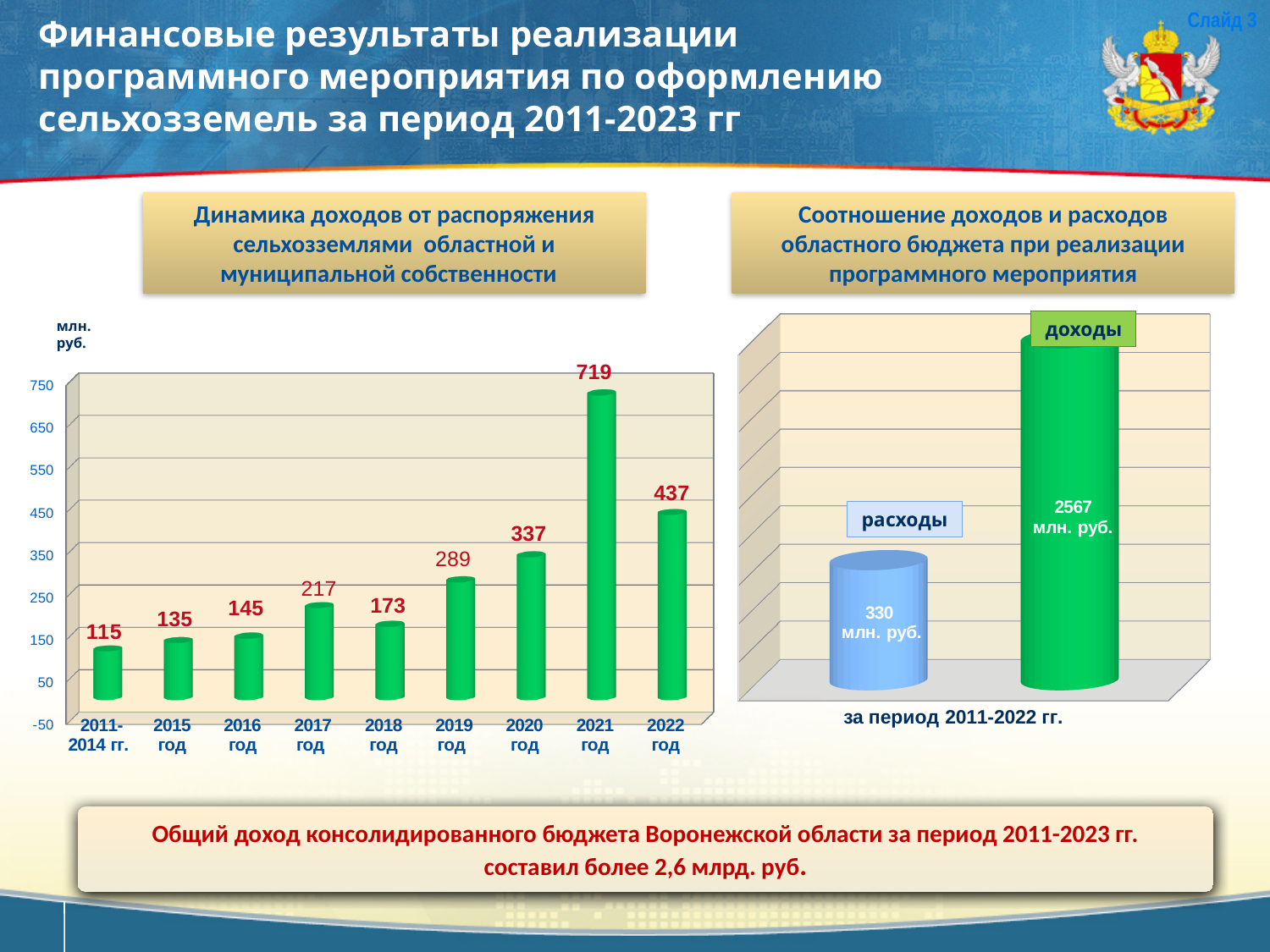
On the right chart (Соотношение доходов и расходов областного бюджета), what is the value for расходы? 330 млн. руб. On the left chart (Динамика доходов от распоряжения сельхозземлями), how many categories are shown on the x axis? 9 On the right chart (Соотношение доходов и расходов областного бюджета), what is the difference between доходы and расходы? 2237 млн. руб. What kind of chart is the left chart (Динамика доходов от распоряжения сельхозземлями)? bar chart On the left chart (Динамика доходов от распоряжения сельхозземлями), which category has the lowest value? 2011-2014 гг. On the left chart (Динамика доходов от распоряжения сельхозземлями), what is the difference between the values for 2021 год and 2022 год? 282 On the left chart (Динамика доходов от распоряжения сельхозземлями), which category has the highest value? 2021 год On the right chart (Соотношение доходов и расходов областного бюджета), what is the value for доходы? 2567 млн. руб. On the left chart (Динамика доходов от распоряжения сельхозземлями), what is the value for 2019 год? 289 On the left chart (Динамика доходов от распоряжения сельхозземлями), what is the value for 2011-2014 гг.? 115 On the left chart (Динамика доходов от распоряжения сельхозземлями), what is the value for 2021 год? 719 On the left chart (Динамика доходов от распоряжения сельхозземлями), which is larger: the value for 2017 год or 2018 год? 2017 год